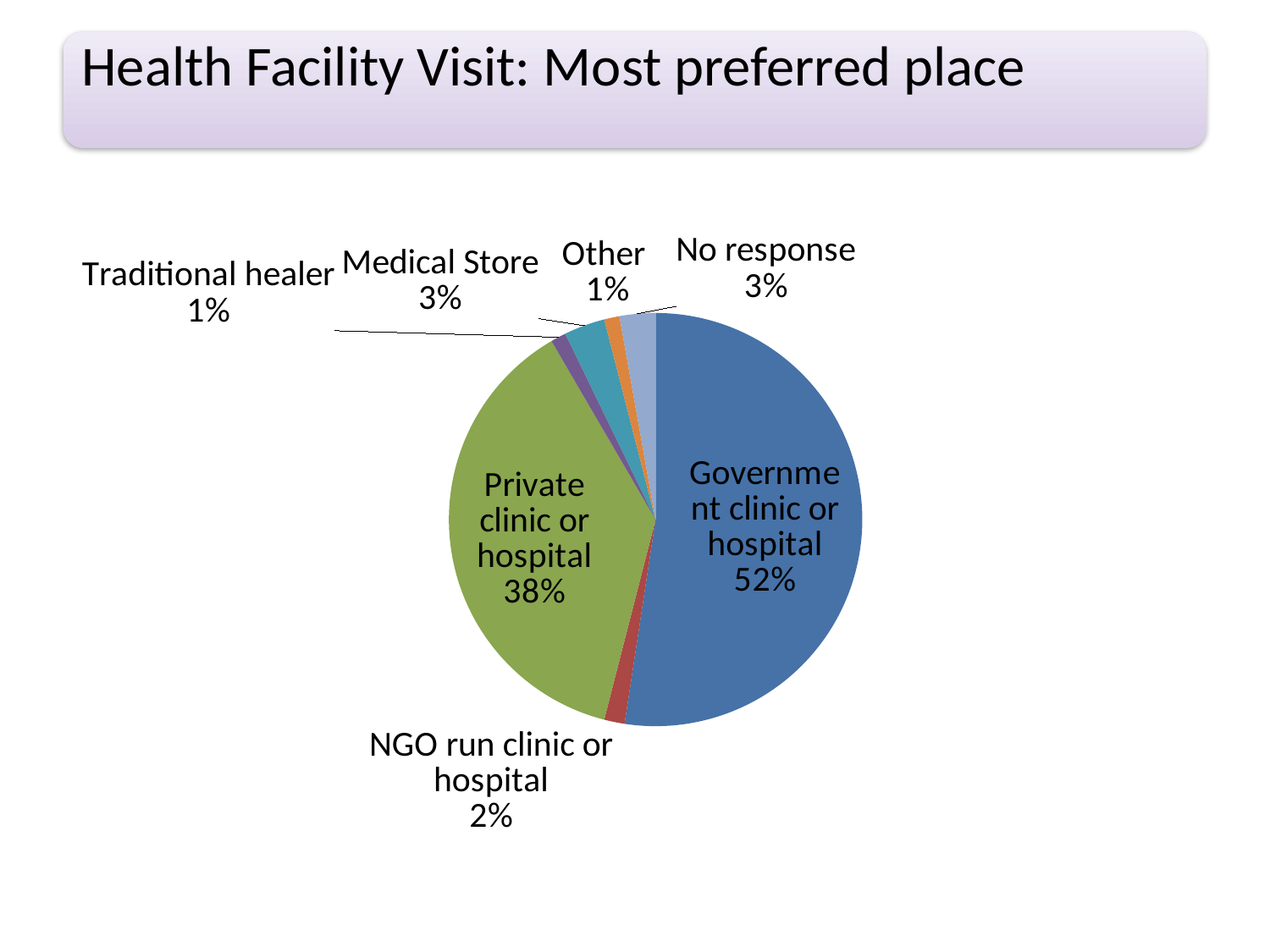
What is the value for Medical Store? 3% What is the title of the slide containing the chart? Health Facility Visit: Most preferred place What is the difference between the Government clinic or hospital share and the Private clinic or hospital share? 14% Which category has the largest slice of the pie? Government clinic or hospital What share of the pie is Government clinic or hospital? 52% What is the value for NGO run clinic or hospital? 2% What is the value for No response? 3% What share of the pie is Private clinic or hospital? 38% How many categories are shown in the pie chart? 7 What kind of chart is shown on the slide? pie chart What is the combined share of Traditional healer and Other? 2% Which is larger, the share for Private clinic or hospital or the share for Government clinic or hospital? Government clinic or hospital